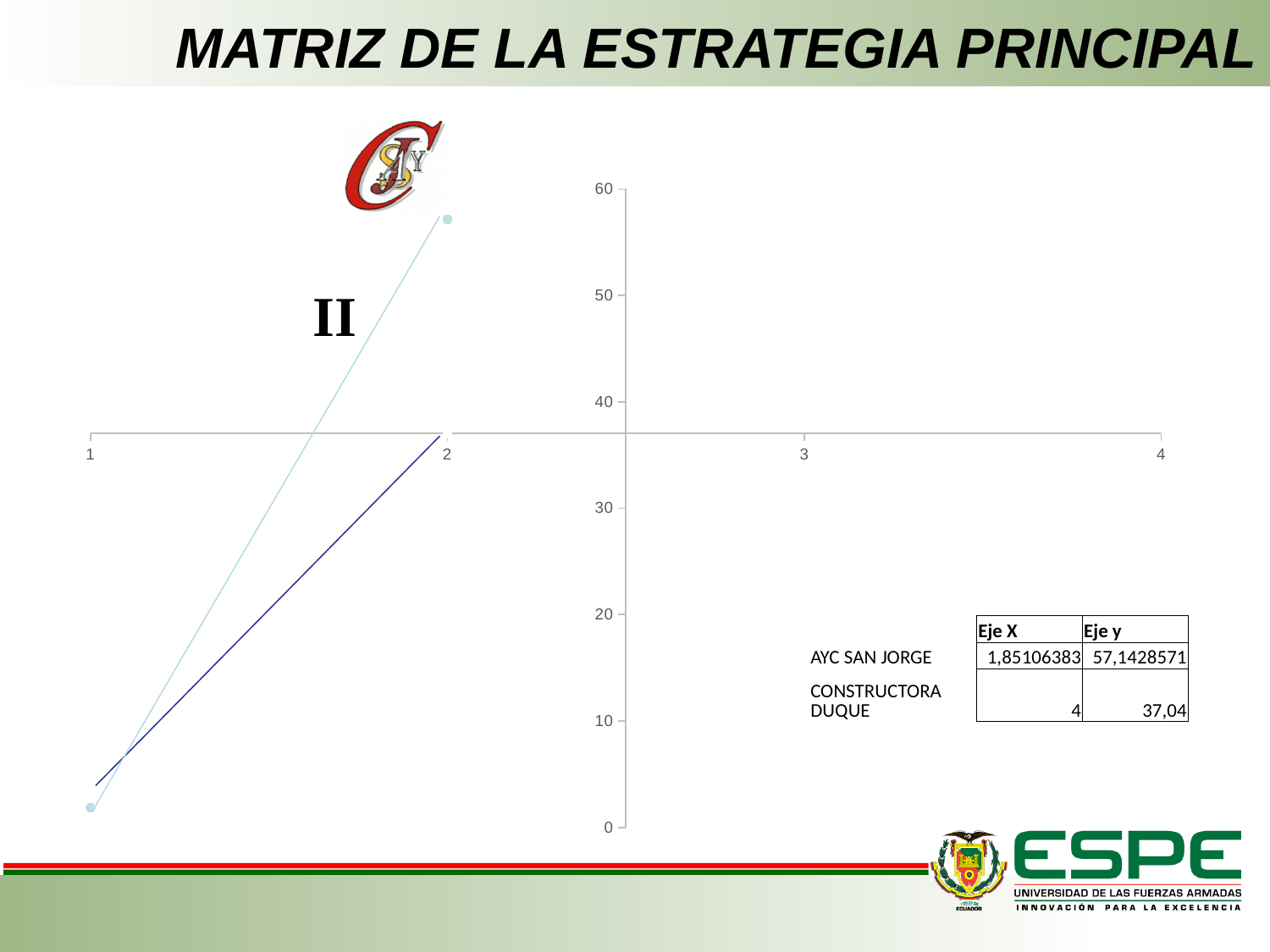
According to the table next to the chart, what is the Eje y value for CONSTRUCTORA DUQUE? 37,04 Which quadrant label is printed on the chart? II What is the highest value shown on the vertical axis of the chart? 60 According to the table next to the chart, what is the Eje X value for CONSTRUCTORA DUQUE? 4 What is the title of the slide containing the chart? MATRIZ DE LA ESTRATEGIA PRINCIPAL Do the plotted lines rise or fall as the x value increases from 1 to 2? rise How many lines are plotted on the chart? 2 What kind of chart is shown on the slide? line chart Is the value of the lower end of the light blue line (at x = 1) greater or less than 10? less According to the table next to the chart, which company has the larger Eje y value, AYC SAN JORGE or CONSTRUCTORA DUQUE? AYC SAN JORGE Is the value of the upper end of the light blue line (at x = 2) greater or less than 50? greater